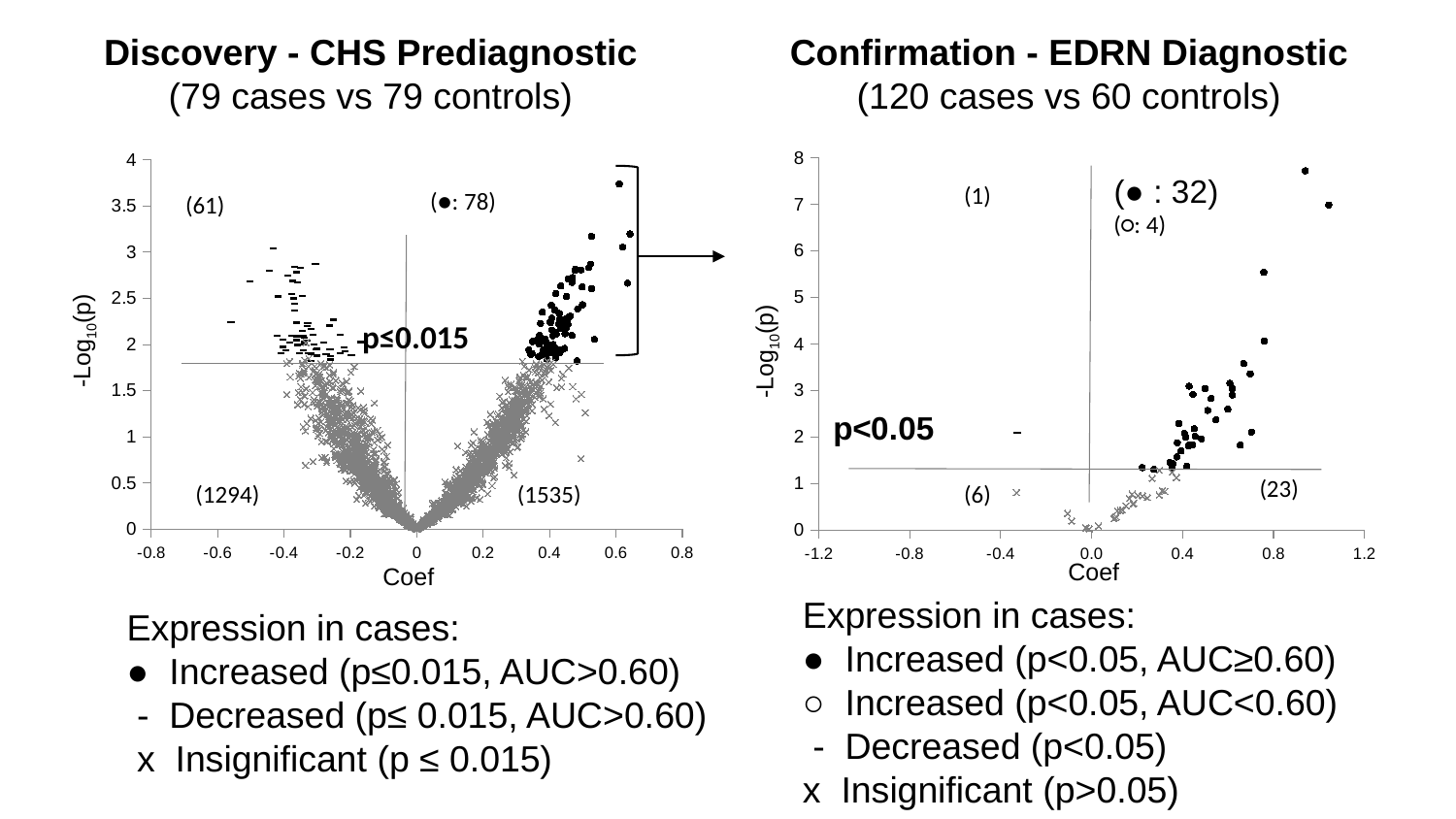
In the Confirmation - EDRN Diagnostic chart, how many proteins are marked with filled circles according to the annotation? 32 In the Discovery - CHS Prediagnostic chart, what is the difference between the lower-right count (1535) and the lower-left count (1294)? 241 In the Discovery - CHS Prediagnostic chart, what count is shown in the lower-right quadrant? 1535 In the Discovery - CHS Prediagnostic chart, how many proteins are marked as increased (filled circles) according to the annotation? 78 In the Confirmation - EDRN Diagnostic chart, what count is shown in the lower-right quadrant? 23 In the Confirmation - EDRN Diagnostic chart, which quadrant count is larger: the lower-left (6) or the lower-right (23)? lower-right (23) What is the label of the x axis on the Discovery - CHS Prediagnostic chart? Coef What kind of chart is the Discovery - CHS Prediagnostic chart? scatter plot In the Confirmation - EDRN Diagnostic chart, how many proteins are marked with open circles according to the annotation? 4 What is the p-value threshold annotated on the Confirmation - EDRN Diagnostic chart? p<0.05 In the Discovery - CHS Prediagnostic chart, what count is shown in the upper-left quadrant? 61 Which chart has the larger count of increased (filled circle) proteins: Discovery - CHS Prediagnostic or Confirmation - EDRN Diagnostic? Discovery - CHS Prediagnostic